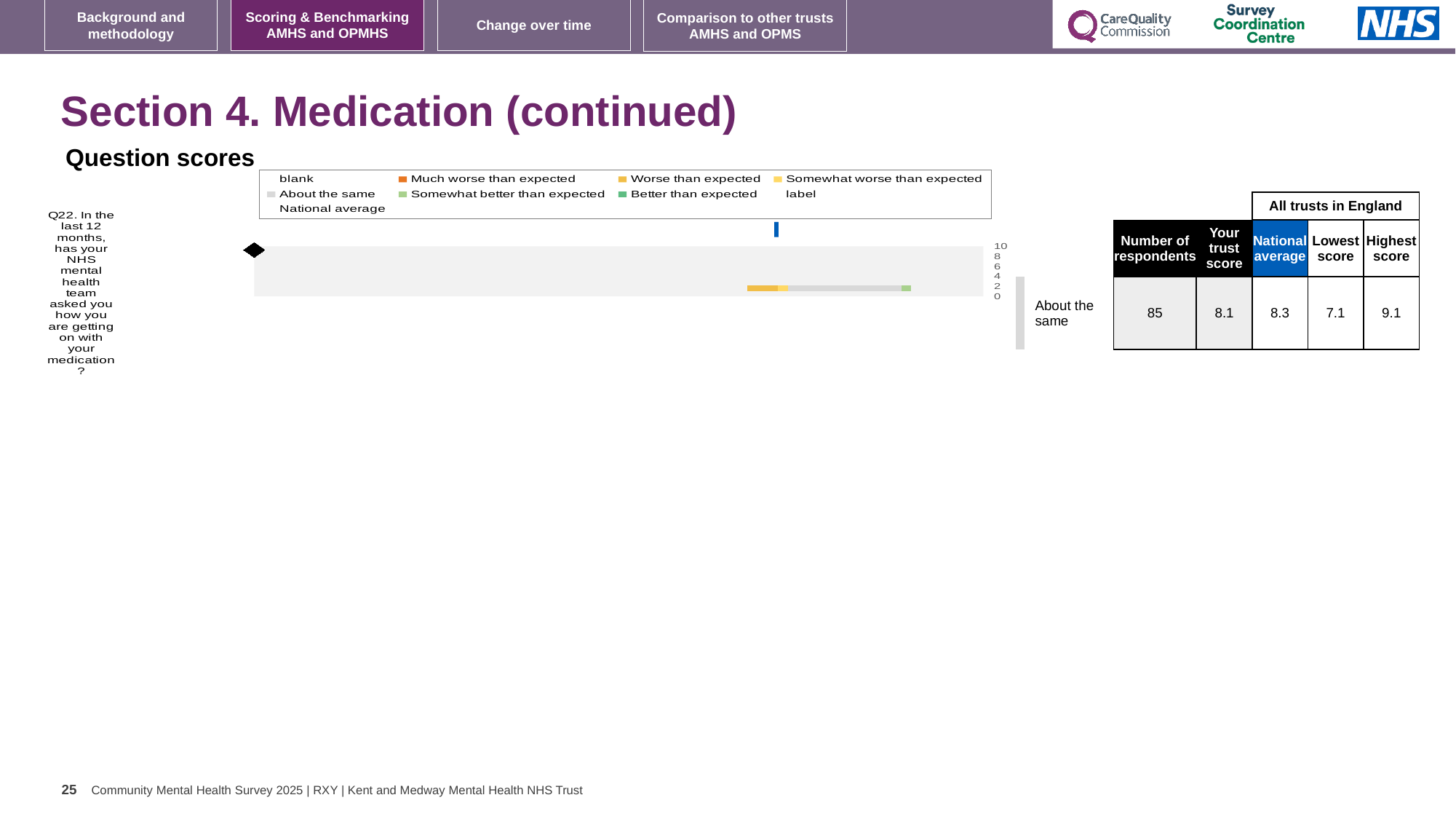
Is the trust's score for Q22 greater or less than 8? greater What kind of chart is shown under 'Question scores'? Bar chart What is the highest score among all trusts in England for Q22? 9.1 How many respondents answered Q22? 85 How many questions are plotted in the Question scores chart? 1 Which is larger for Q22, the trust's score or the national average? National average What is the national average score for Q22? 8.3 Which question is plotted in the Question scores chart? Q22. In the last 12 months, has your NHS mental health team asked you how you are getting on with your medication? What is the lowest score among all trusts in England for Q22? 7.1 What is the trust's score for Q22? 8.1 How is the trust's score for Q22 categorised relative to expectations? About the same What is the difference between the highest and lowest trust scores for Q22? 2.0